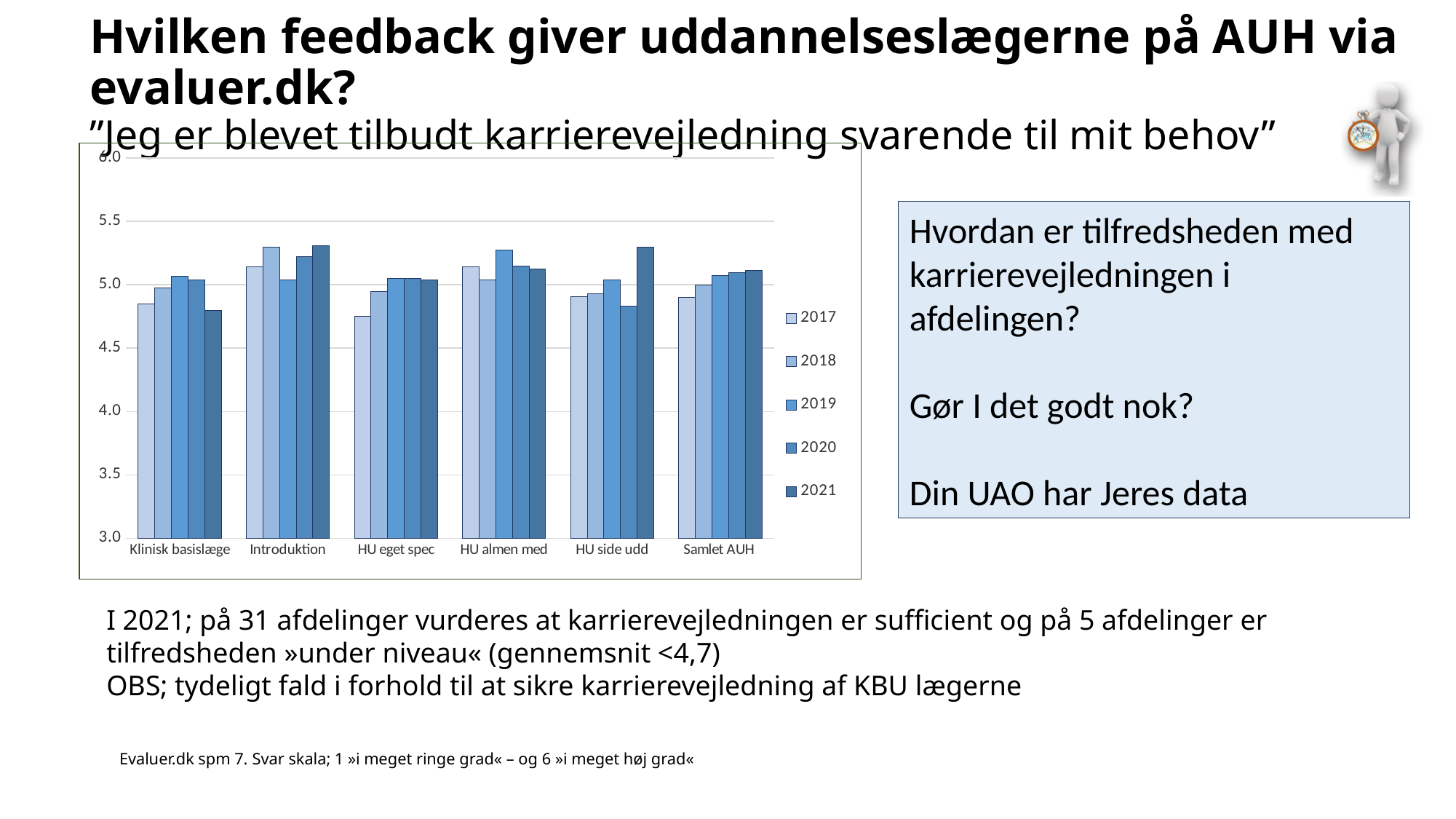
Is the 2017 value for HU eget spec greater or less than 5.0? less Is the 2021 value for HU side udd greater or less than 5.0? greater What kind of chart is shown on the slide? bar chart Is the 2021 value for Introduktion greater or less than 5.0? greater Which years are listed in the chart's legend? 2017, 2018, 2019, 2020, 2021 For Samlet AUH, do the values rise or fall from 2017 to 2021? rise For Klinisk basislæge, which year has the lowest value? 2021 For HU side udd, which year has the highest value? 2021 For Klinisk basislæge, which is larger: the 2019 value or the 2021 value? 2019 How many categories are shown on the x axis of the chart? 6 How many series does the chart's legend list? 5